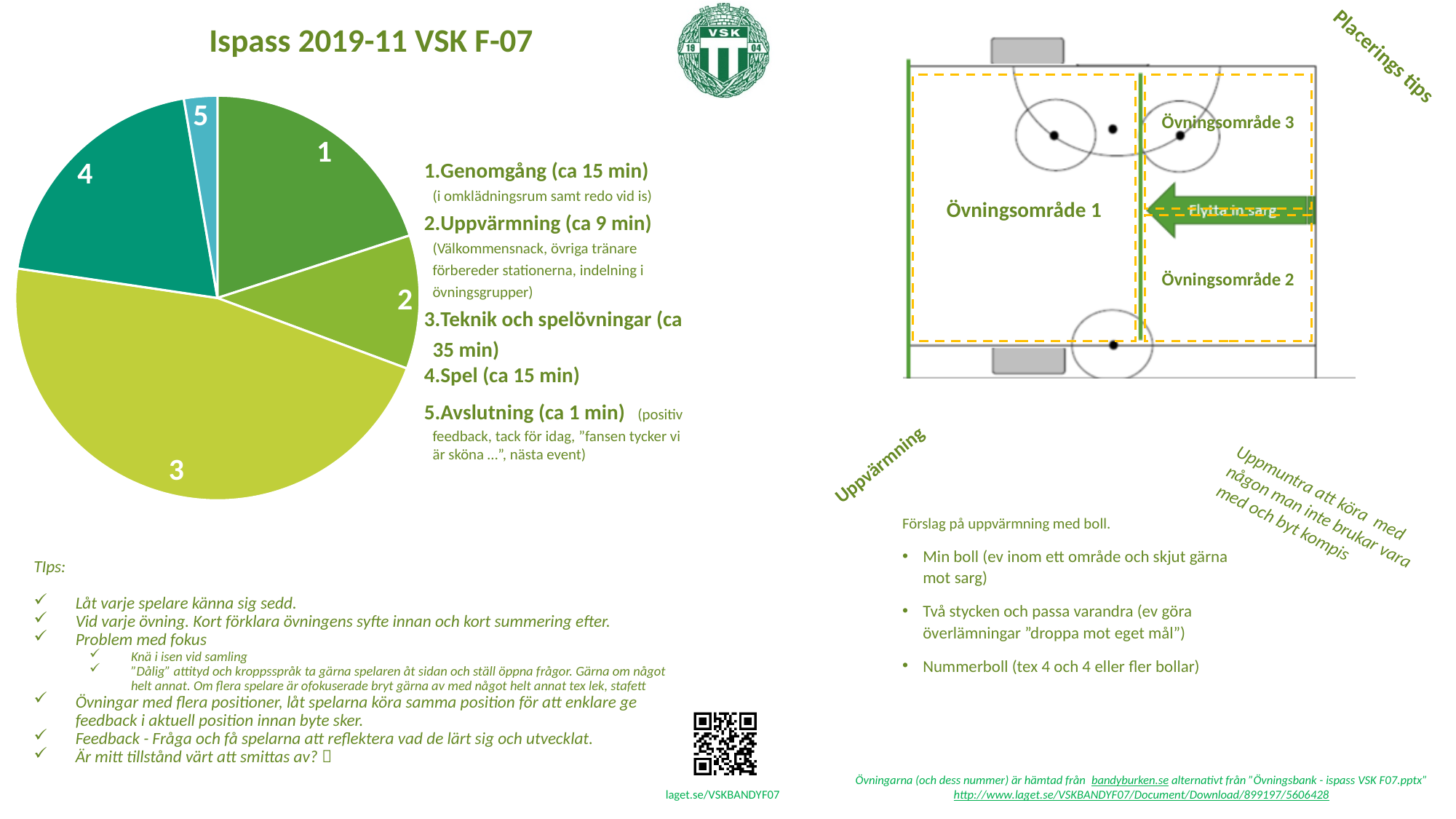
In the pie chart, which slice is larger, 4 or 5? 4 What colour is slice 5 in the pie chart? light blue What kind of chart is shown on the left of the slide? pie chart How many slices does the pie chart have? 5 According to the list next to the pie chart, which activity does slice 3 represent? Teknik och spelövningar Which slice of the pie chart is the smallest? 5 Which slice of the pie chart is the largest? 3 In the pie chart, which slice is larger, 2 or 4? 4 In the pie chart, which slice is larger, 1 or 2? 1